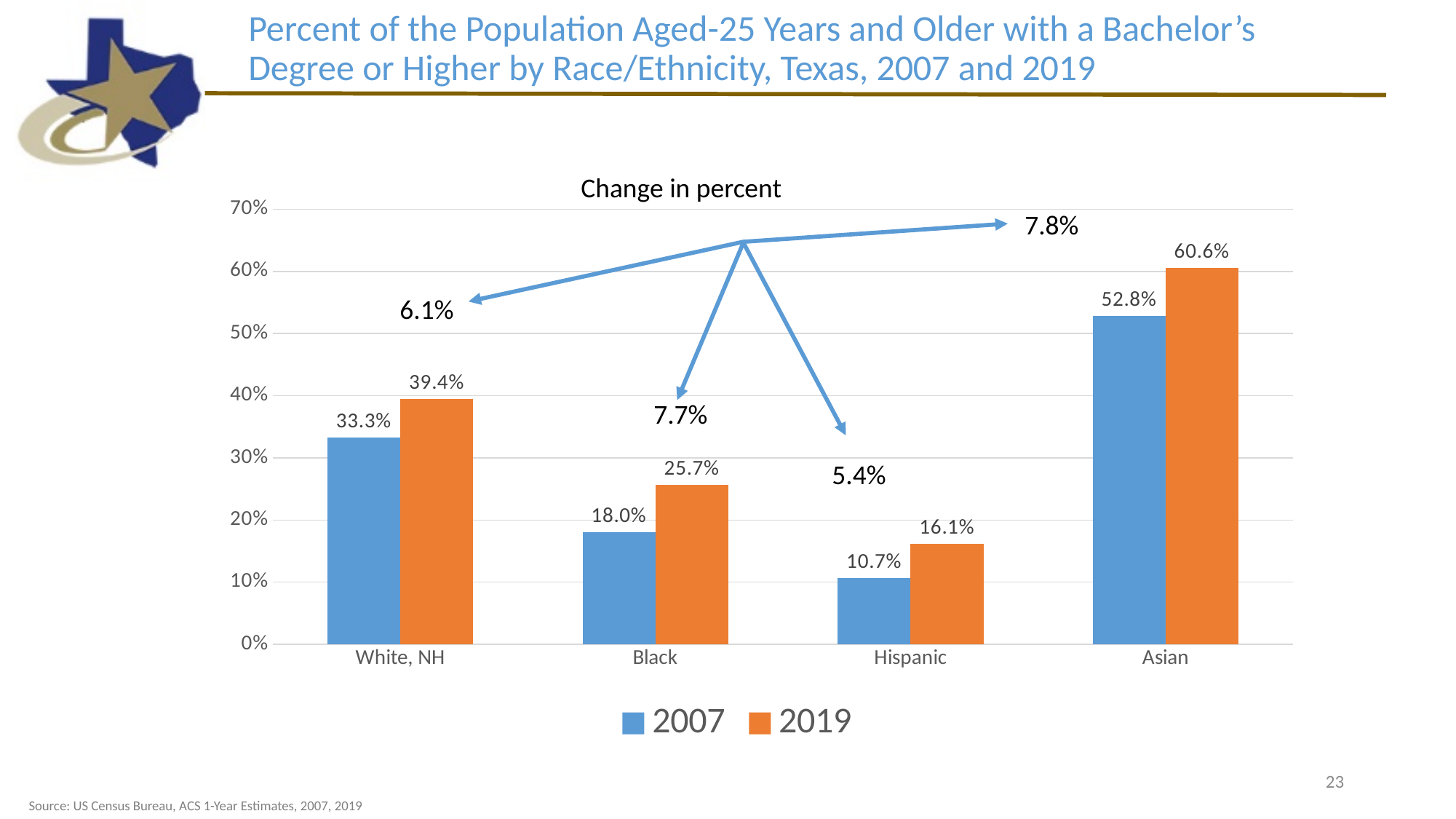
What is the 2019 value for Asian? 60.6% What kind of chart is shown on the slide? Bar chart What is the difference between the 2019 values for Asian and Black? 34.9% What is the 2019 value for Black? 25.7% What is the 2007 value for Hispanic? 10.7% Which is larger: the 2007 value for White, NH or the 2019 value for Black? 2007 value for White, NH Which category has the lowest 2019 value? Hispanic Which category has the highest 2007 value? Asian What is the difference between the 2019 and 2007 values for White, NH? 6.1% Which colour represents the 2019 series in the legend? Orange How many race/ethnicity categories are shown on the x axis? 4 How many series does the legend list? 2